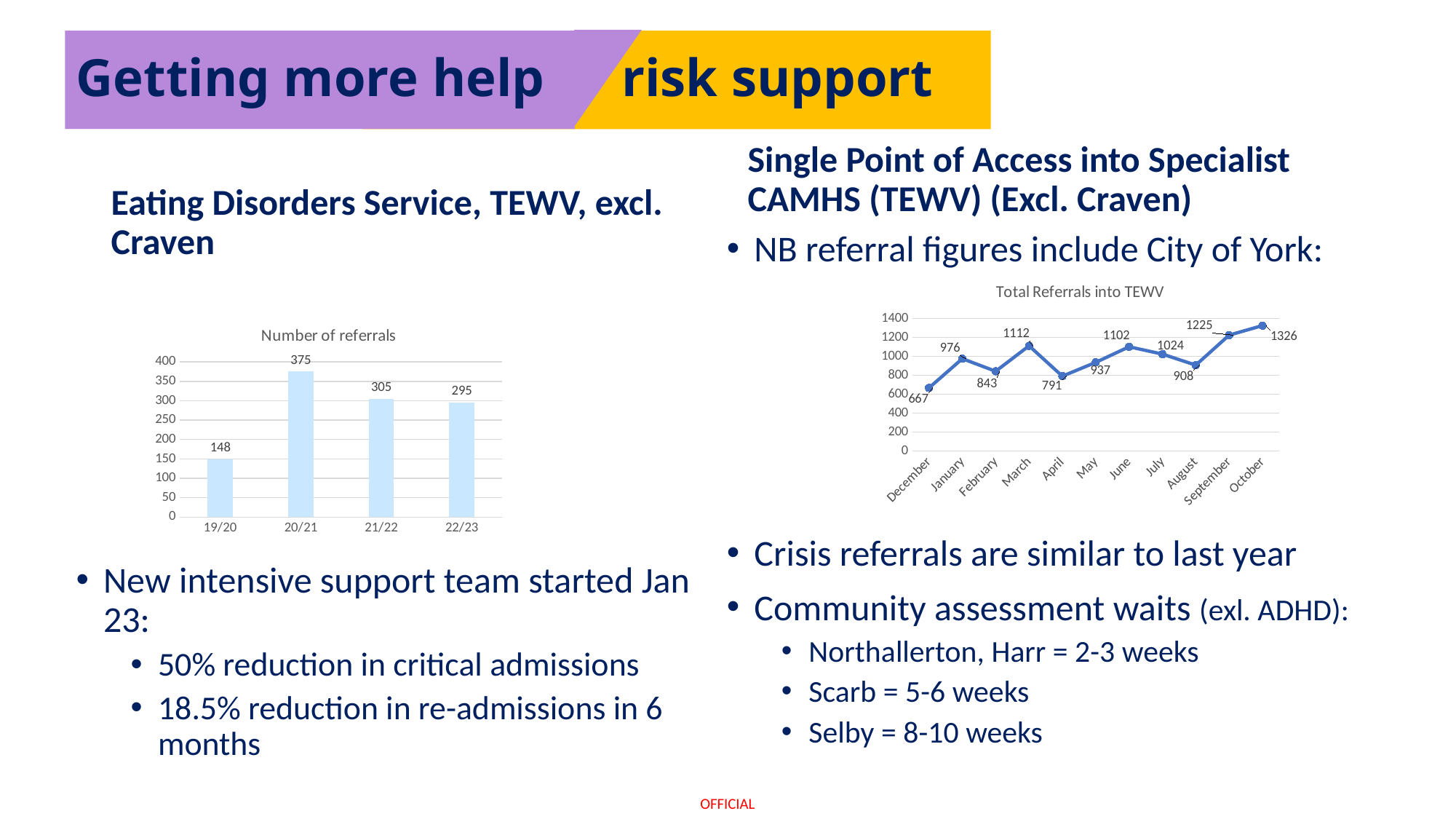
In the 'Number of referrals' chart, how many years are shown? 4 What kind of chart is the 'Total Referrals into TEWV' chart? Line chart In the 'Total Referrals into TEWV' chart, which month has the highest value? October In the 'Number of referrals' chart, what is the difference between the 20/21 and 22/23 values? 80 What kind of chart is the 'Number of referrals' chart? Bar chart In the 'Total Referrals into TEWV' chart, what is the difference between the October and September values? 101 In the 'Number of referrals' chart, what is the value for 20/21? 375 In the 'Total Referrals into TEWV' chart, which is larger, the value for June or the value for July? June In the 'Total Referrals into TEWV' chart, how many months are plotted? 11 In the 'Total Referrals into TEWV' chart, which month has the lowest value? December In the 'Total Referrals into TEWV' chart, what is the value for March? 1112 In the 'Number of referrals' chart, which year has the lowest number of referrals? 19/20